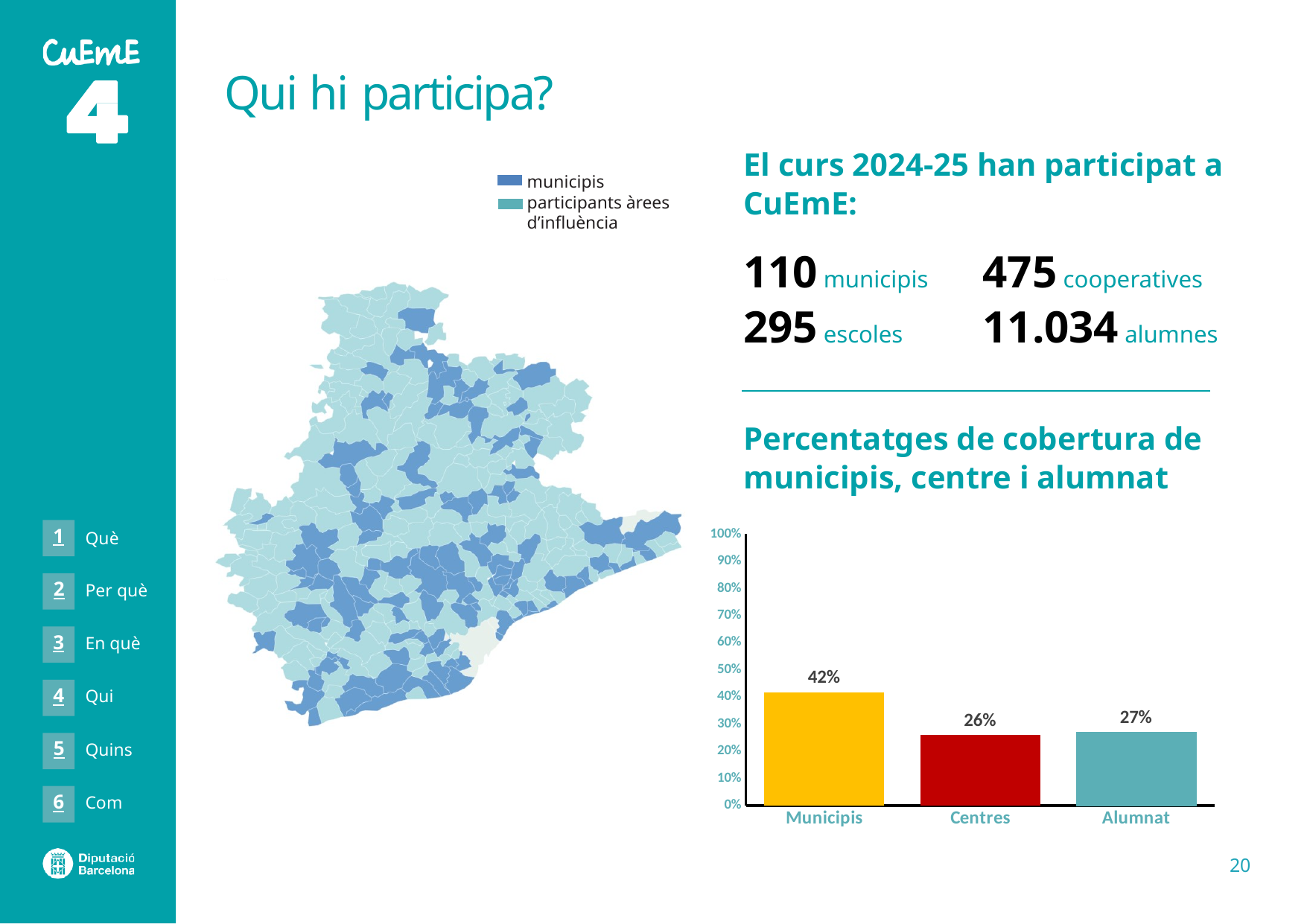
Is the value for Centres greater or less than 30% in the bar chart? less What is the difference in percentage points between Municipis and Centres in the bar chart? 16 What is the difference in percentage points between Municipis and Alumnat in the bar chart? 15 Which category has the lowest coverage percentage in the bar chart? Centres What is the coverage percentage for Centres in the bar chart? 26% How many categories are shown in the bar chart? 3 Is the value for Municipis greater or less than 40% in the bar chart? greater What is the coverage percentage for Municipis in the bar chart? 42% Which category has the highest coverage percentage in the bar chart? Municipis What is the title of the bar chart? Percentatges de cobertura de municipis, centre i alumnat What kind of chart shows the coverage percentages? bar chart What is the coverage percentage for Alumnat in the bar chart? 27%